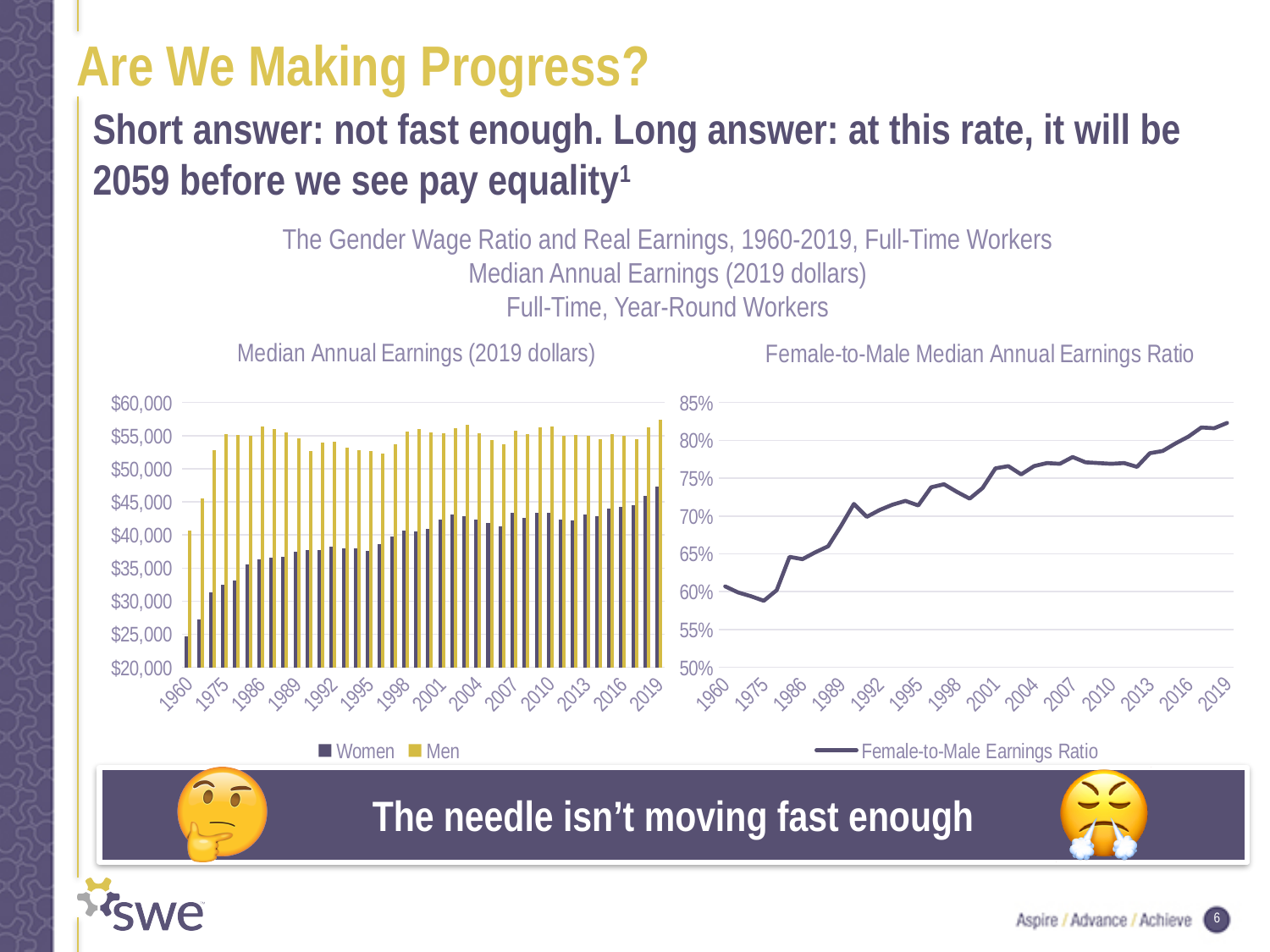
What kind of chart is the 'Median Annual Earnings (2019 dollars)' chart on the left? bar chart In the right 'Female-to-Male Median Annual Earnings Ratio' chart, is the value for 2019 greater or less than 80%? greater In the right 'Female-to-Male Median Annual Earnings Ratio' chart, does the ratio generally rise or fall from 1960 to 2019? rise In the right 'Female-to-Male Median Annual Earnings Ratio' chart, is the value for 1975 greater or less than 60%? less In the left 'Median Annual Earnings (2019 dollars)' chart, which series has the higher value in 2019, Women or Men? Men In the left 'Median Annual Earnings (2019 dollars)' chart, is the value for Women in 2019 greater or less than $45,000? greater How many series does the legend of the left 'Median Annual Earnings (2019 dollars)' chart list? 2 What is the name of the series shown in the legend of the right 'Female-to-Male Median Annual Earnings Ratio' chart? Female-to-Male Earnings Ratio What kind of chart is the 'Female-to-Male Median Annual Earnings Ratio' chart on the right? line chart What are the two series named in the legend of the left 'Median Annual Earnings (2019 dollars)' chart? Women and Men